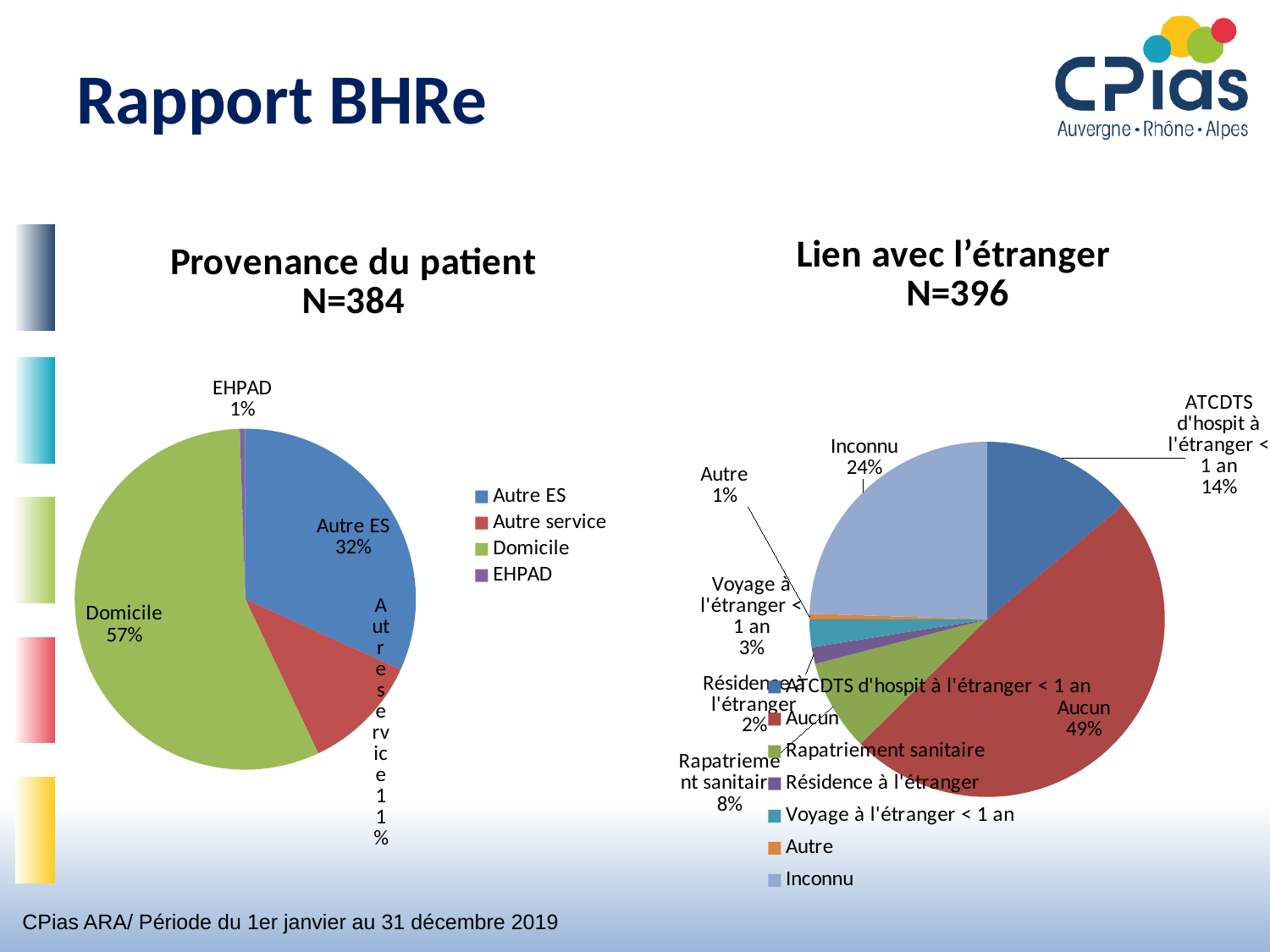
What type of chart is used for 'Lien avec l'étranger'? Pie chart In the 'Provenance du patient' chart, which category has the smallest share? EHPAD In the 'Lien avec l'étranger' chart, how many categories does the legend list? 7 In the 'Lien avec l'étranger' chart, what percentage is shown for Inconnu? 24% In the 'Provenance du patient' chart, how many categories does the legend list? 4 In the 'Lien avec l'étranger' chart, which is larger: ATCDTS d'hospit à l'étranger < 1 an or Voyage à l'étranger < 1 an? ATCDTS d'hospit à l'étranger < 1 an In the 'Lien avec l'étranger' chart, what percentage is shown for Rapatriement sanitaire? 8% In the 'Provenance du patient' chart, what is the difference in percentage points between Domicile and Autre ES? 25 In the 'Lien avec l'étranger' chart, what share is labelled Aucun? 49% In the 'Provenance du patient' chart, which category has the largest share? Domicile In the 'Provenance du patient' chart, what percentage is shown for Autre ES? 32% In the 'Provenance du patient' chart, what share of patients come from Domicile? 57%